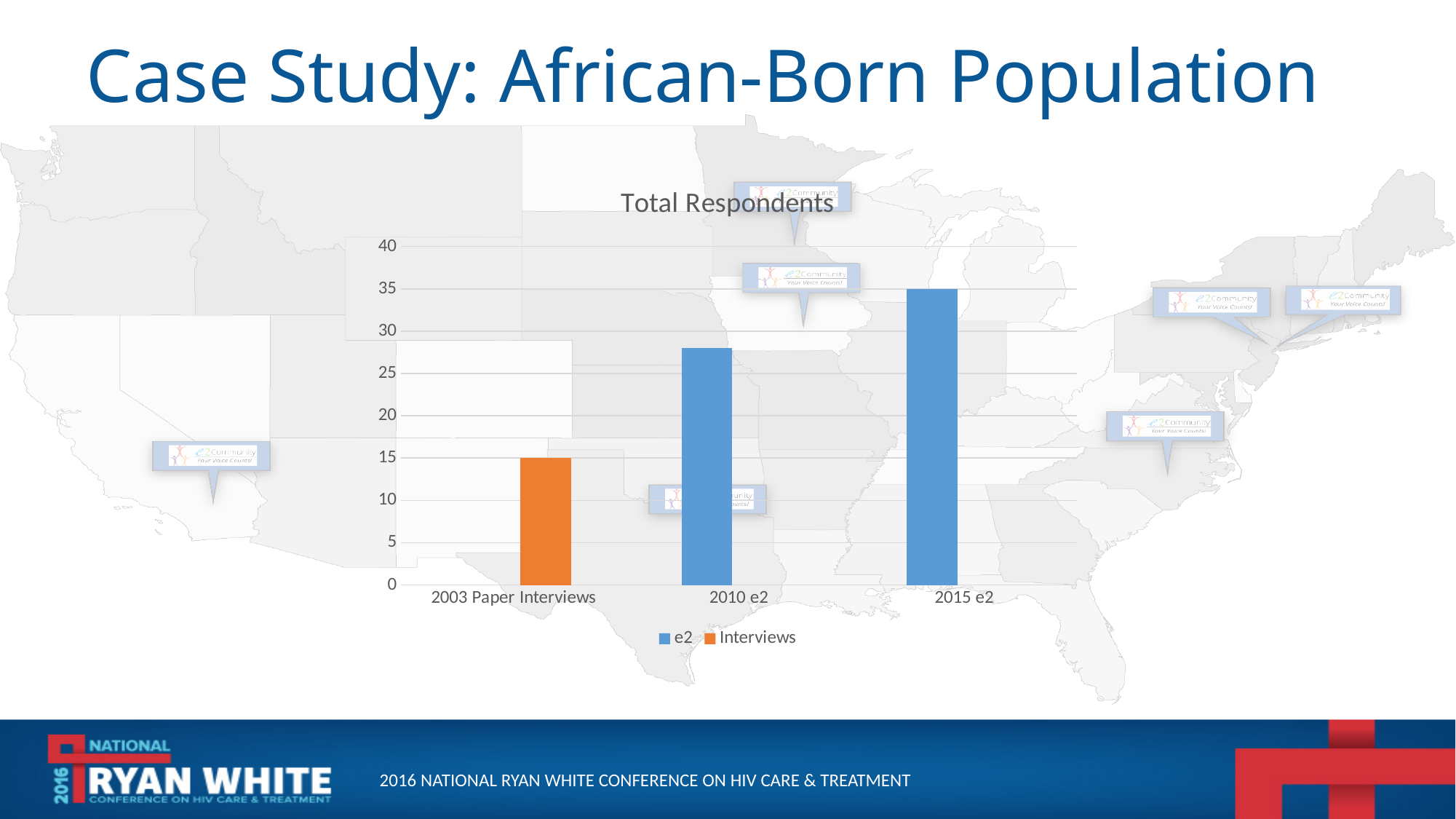
What kind of chart is shown under the title "Total Respondents"? bar chart How many series does the legend of the Total Respondents chart list? 2 Which category has the lowest value in the Total Respondents chart? 2003 Paper Interviews Do the values rise or fall from left to right across the Total Respondents chart? rise Is the value for 2010 e2 greater or less than 25? greater What is the value for 2015 e2 in the Total Respondents chart? 35 Which category has the highest value in the Total Respondents chart? 2015 e2 What is the value for 2003 Paper Interviews in the Total Respondents chart? 15 Is the value for 2010 e2 greater or less than 30? less How many categories are shown on the x axis of the Total Respondents chart? 3 Which is larger, the value for 2010 e2 or the value for 2015 e2? 2015 e2 What is the difference between the values for 2015 e2 and 2003 Paper Interviews? 20